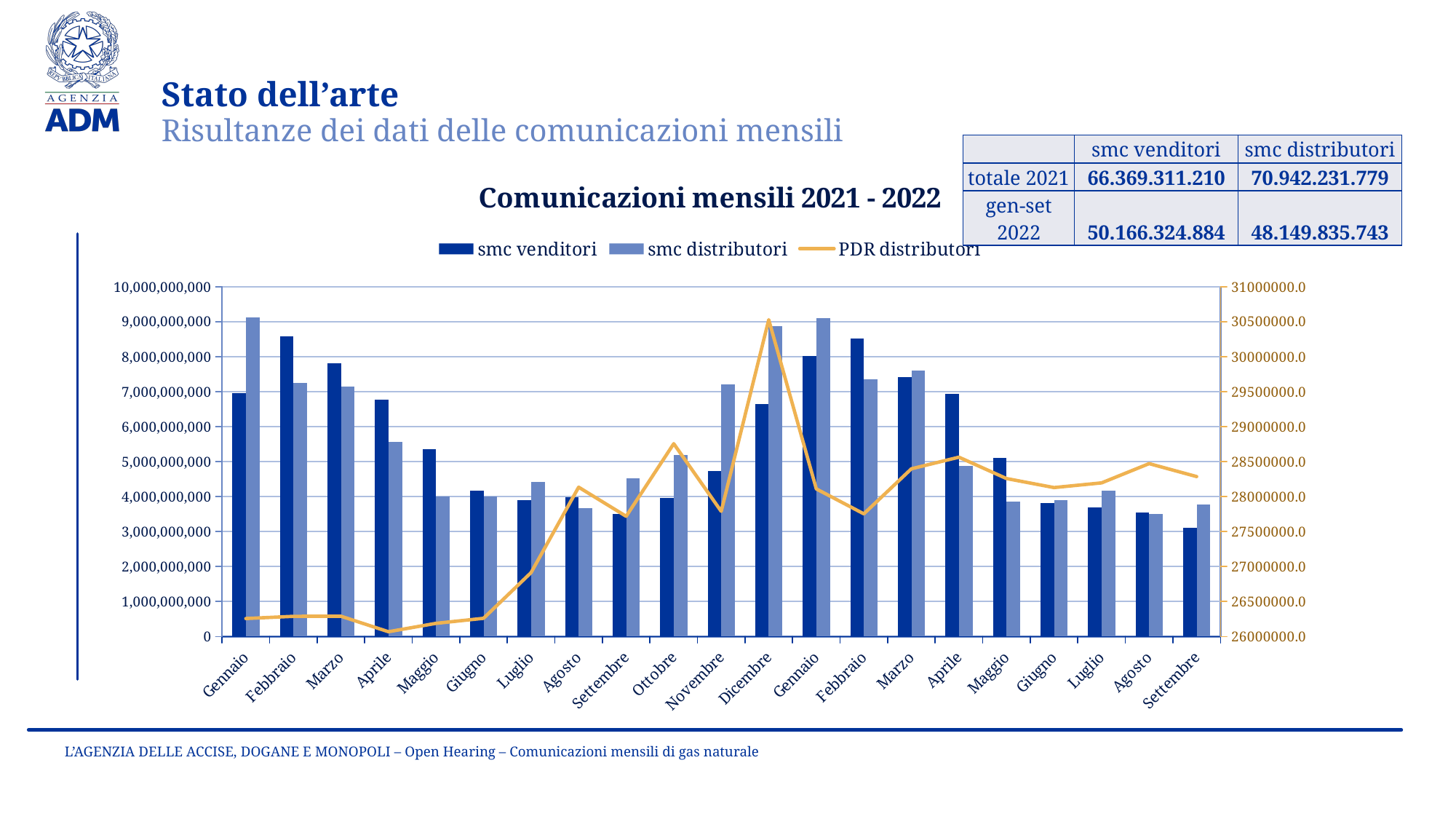
Is the PDR distributori value for Dicembre 2021 greater or less than 30000000.0? greater In which month does the PDR distributori line reach its highest value? Dicembre (2021) Is the smc venditori value for the first Gennaio (2021) greater or less than 6,000,000,000? greater How many months (categories) are plotted along the x axis of the chart? 21 Is the smc venditori value for Settembre 2022 greater or less than 4,000,000,000? less In which month is the PDR distributori line at its lowest value? Aprile (2021) Which month has the lowest smc venditori bar? Settembre (2022) For the first Gennaio (2021), which is larger: smc venditori or smc distributori? smc distributori How many series does the chart legend list? 3 What type of chart is shown on the slide? bar chart with a line series For Maggio 2021, which is larger: smc venditori or smc distributori? smc venditori